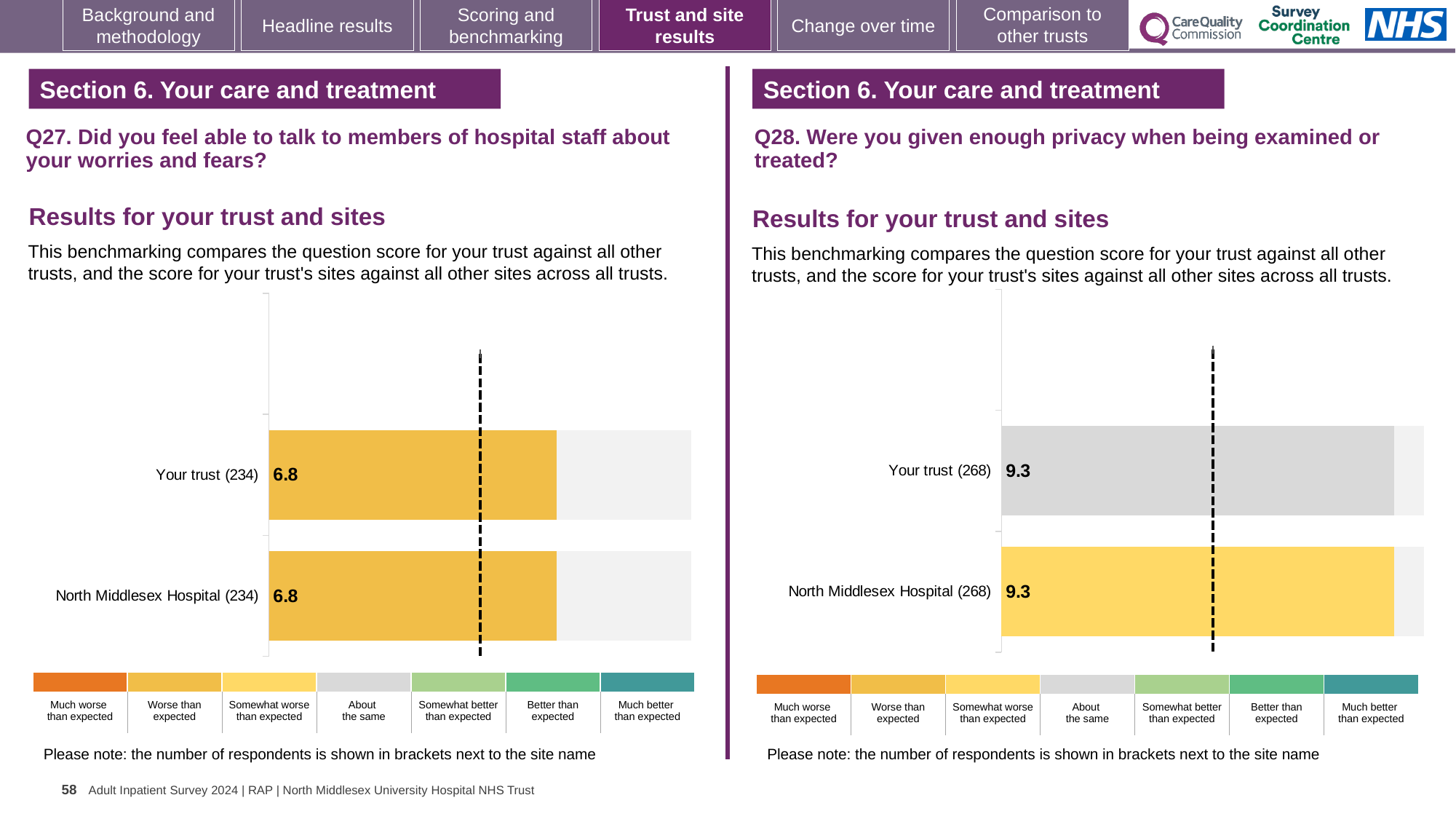
What type of chart is used in the Q27 chart on the left? Bar chart How many categories does the colour legend below the Q27 chart on the left list? 7 In the Q28 chart on the right, which benchmark category does the grey colour of the Your trust bar correspond to in the legend? About the same In the Q28 chart on the right, what is the score for North Middlesex Hospital? 9.3 In the Q28 chart on the right, how many respondents are shown in brackets for Your trust? 268 How many bars are plotted in the Q28 chart on the right? 2 In the Q27 chart on the left, what is the score for Your trust? 6.8 In the Q27 chart on the left, what is the score for North Middlesex Hospital? 6.8 In the Q28 chart on the right, what is the score for Your trust? 9.3 In the Q27 chart on the left, how many respondents are shown in brackets for North Middlesex Hospital? 234 Is the score for Your trust in the Q28 chart on the right larger than the score for Your trust in the Q27 chart on the left? Yes In the Q27 chart on the left, what is the difference between the score for Your trust and the score for North Middlesex Hospital? 0